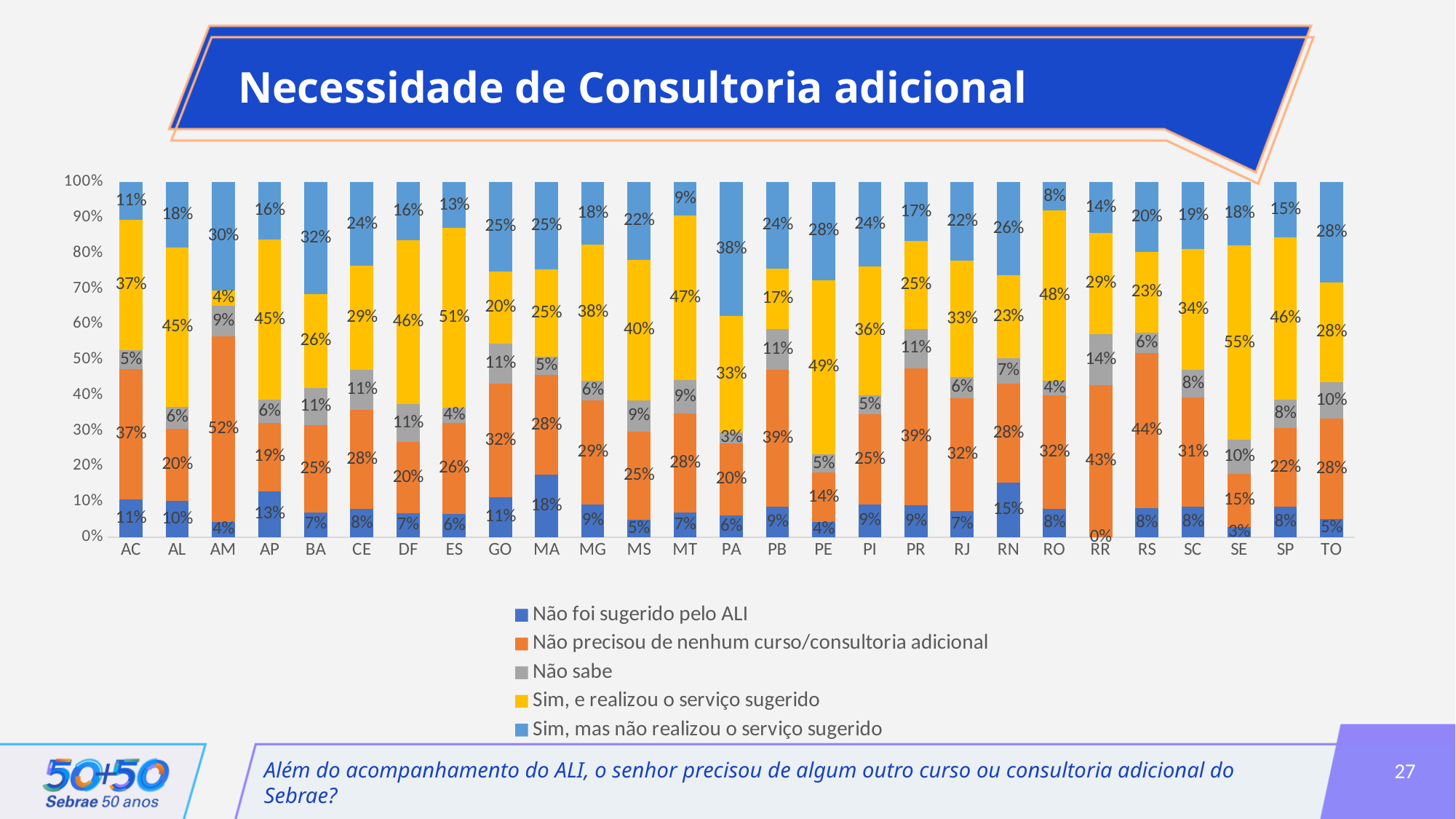
Which state has the lowest value for "Sim, e realizou o serviço sugerido"? AM Which state has the highest value for "Não foi sugerido pelo ALI"? MA How many series does the legend list? 5 What is the value of "Não precisou de nenhum curso/consultoria adicional" for AM? 52% What type of chart is shown on the slide? stacked bar chart What is the difference between the "Sim, e realizou o serviço sugerido" values for ES and GO? 31% What is the value of "Não sabe" for TO? 10% What is the value of "Não foi sugerido pelo ALI" for RR? 0% Which state has the highest value for "Sim, mas não realizou o serviço sugerido"? PA Which is larger: the "Não sabe" value for RR or for PA? RR What is the value of "Sim, e realizou o serviço sugerido" for SE? 55% How many states (categories) are shown on the x axis? 27